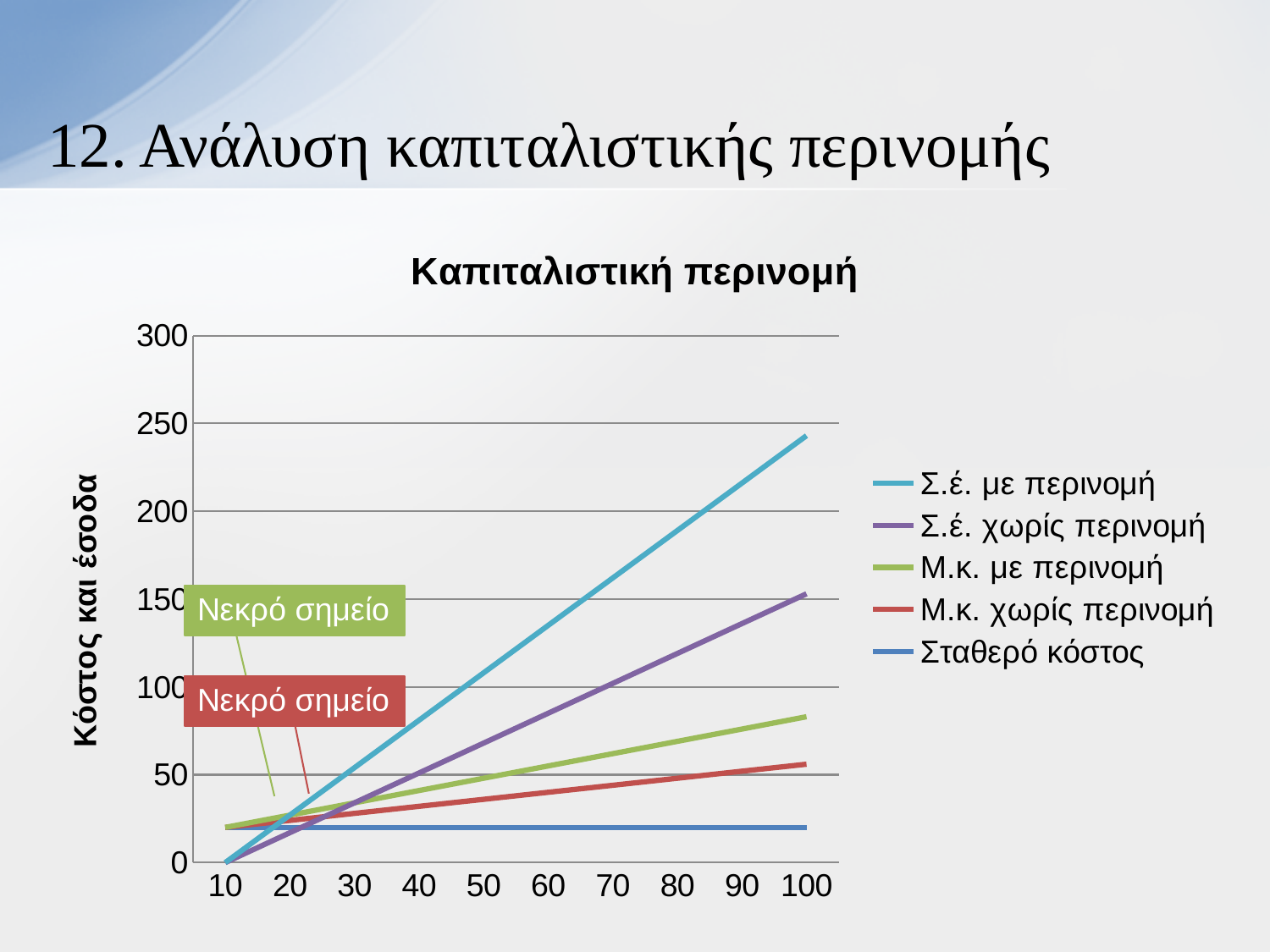
Which series has the lowest value at x = 100? Σταθερό κόστος Is the value of Σ.έ. με περινομή at x = 100 greater or less than 200? greater What kind of chart is shown on the slide? line chart Does the Σταθερό κόστος line rise, fall or stay flat as x increases from 10 to 100? stays flat Which series has the highest value at x = 100? Σ.έ. με περινομή Is the value of Μ.κ. με περινομή at x = 100 greater or less than 100? less At x = 100, which is larger: Μ.κ. με περινομή or Μ.κ. χωρίς περινομή? Μ.κ. με περινομή Is the value of Σ.έ. χωρίς περινομή at x = 100 greater or less than 200? less How many tick values are shown along the x axis? 10 What is the label on the vertical axis of the chart? Κόστος και έσοδα What is the title of the chart? Καπιταλιστική περινομή How many series does the legend list? 5